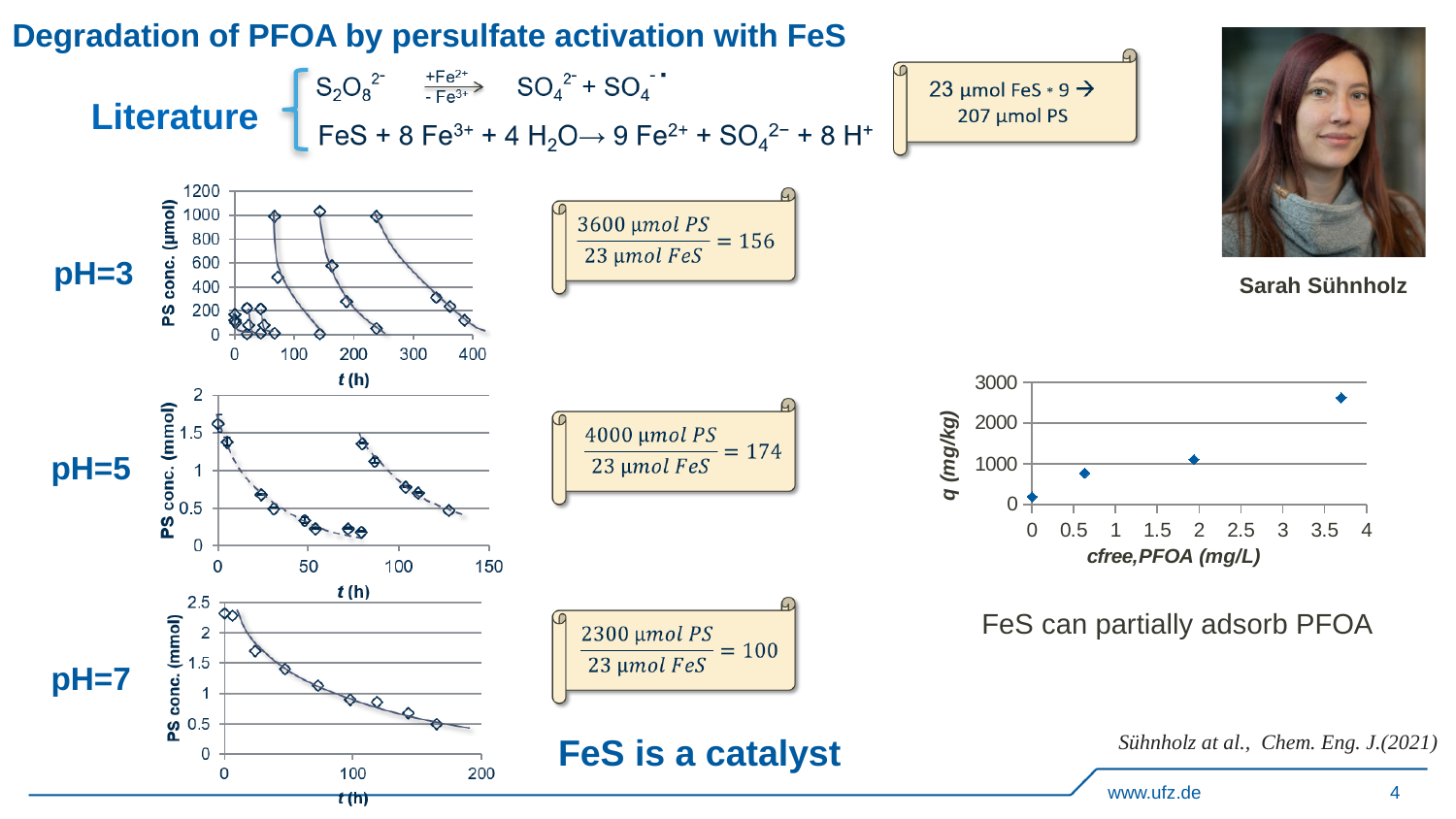
In the chart with the x axis cfree,PFOA (mg/L), do the q values rise or fall as cfree,PFOA increases? rise What kind of chart is the chart labelled pH=3? scatter chart In the chart labelled pH=3, is the highest plotted PS conc. value greater or less than 800? greater In the chart with the x axis cfree,PFOA (mg/L), is the q value of the point at about 3.7 mg/L greater or less than 2000? greater In the chart labelled pH=3, what is the highest value shown on the y axis (PS conc.)? 1200 In the chart labelled pH=5, is the PS conc. value at t = 0 h greater or less than 1? greater In the chart labelled pH=5, do the PS conc. values rise or fall over the first 80 hours? fall In the chart labelled pH=7, what is the highest value shown on the x axis (t)? 200 In the chart labelled pH=7, do the PS conc. values rise or fall as t increases? fall In the chart with the x axis cfree,PFOA (mg/L), how many data points are plotted? 4